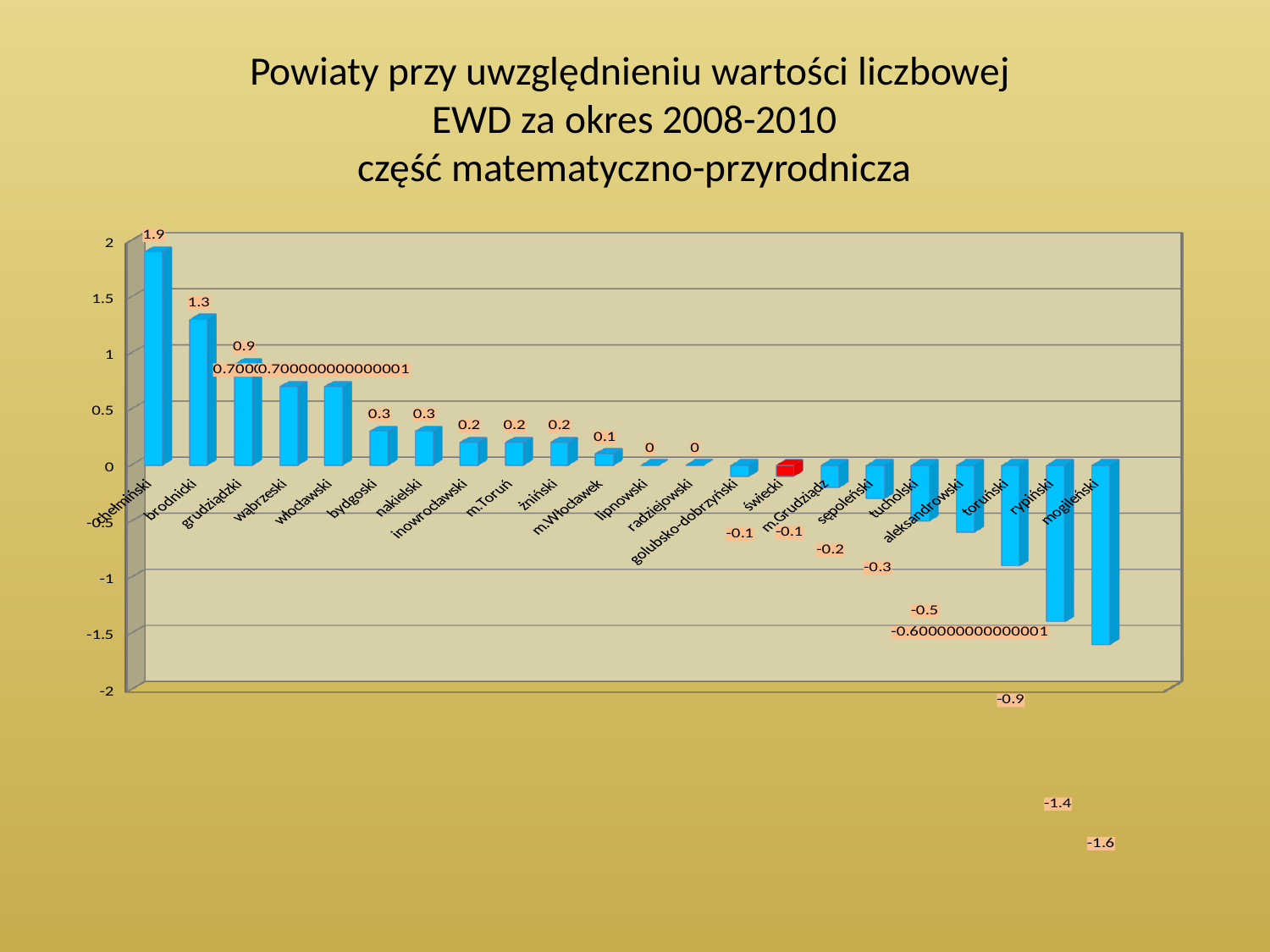
Which powiat has the highest value? chełmiński Which powiat has the lowest value? mogileński What is the value for brodnicki? 1.3 What is the value for mogileński? -1.6 What is the value for rypiński? -1.4 Which has a larger value, grudziądzki or bydgoski? grudziądzki What kind of chart is this? bar chart Which powiat's bar is coloured red? świecki Is the value for brodnicki greater or less than 1? greater How many powiats are shown on the x axis? 22 What is the value for chełmiński? 1.9 What is the difference between the values for chełmiński and brodnicki? 0.6